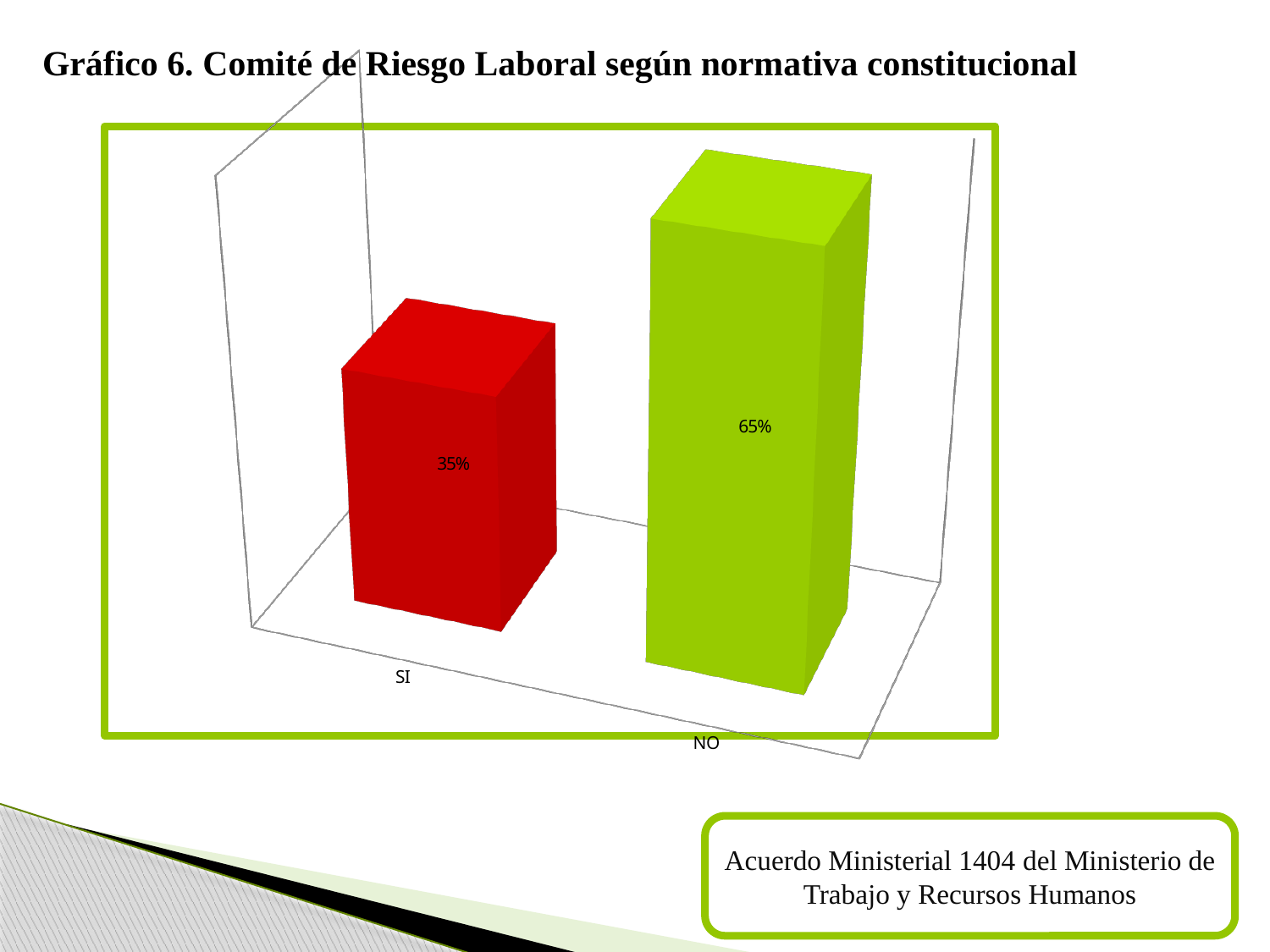
What is the value for NO? 65% What is the difference between the values for NO and SI? 30% Which category has the highest value? NO What kind of chart is shown on the slide? Bar chart Which is larger, the value for SI or the value for NO? NO How many categories are shown in the chart? 2 What is the value for SI? 35% What colour is the bar for SI? Red Which category has the lowest value? SI What is the title of the chart? Gráfico 6. Comité de Riesgo Laboral según normativa constitucional